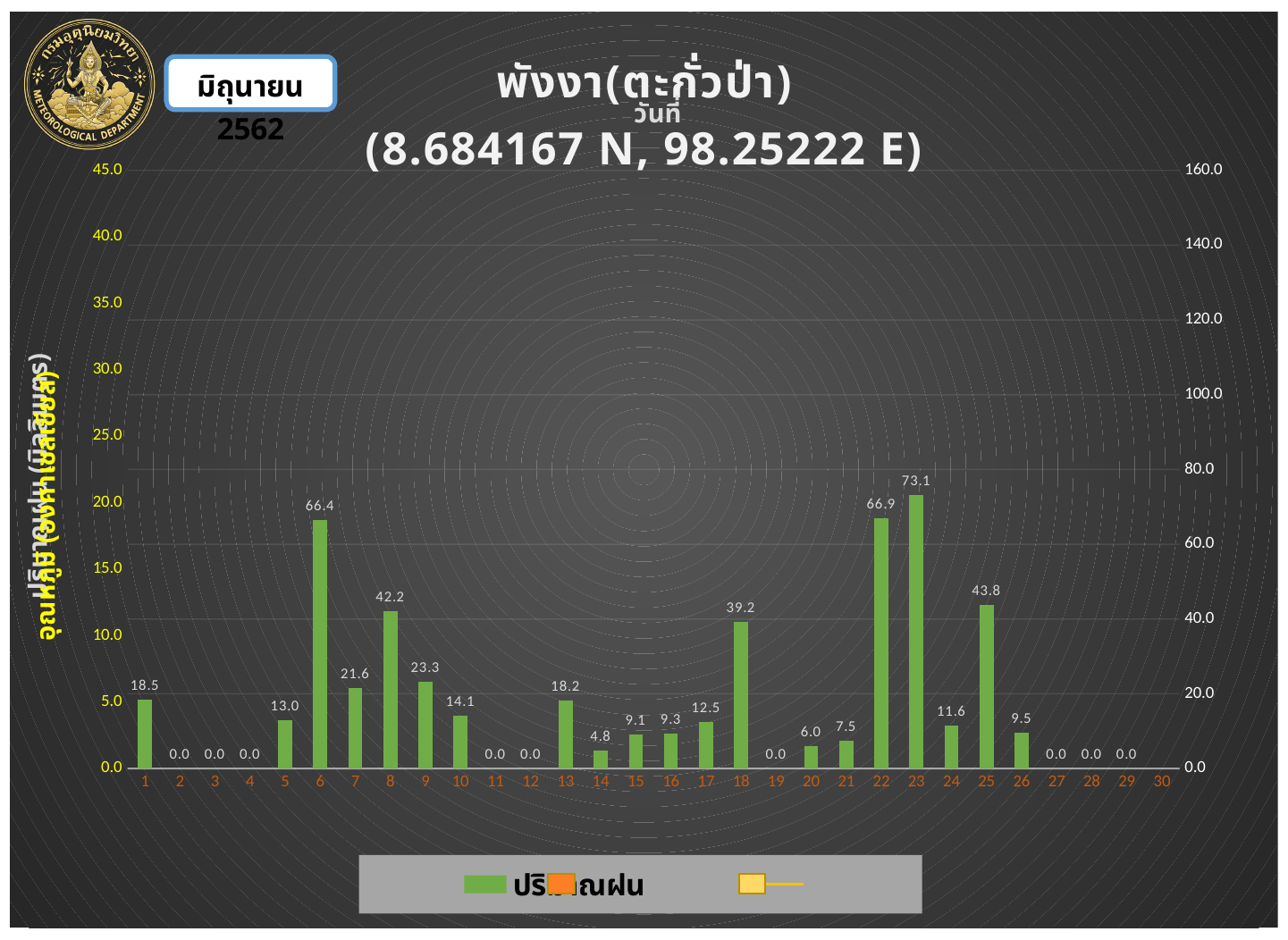
What kind of chart is shown on the slide? bar chart Which is larger, the value for day 8 or the value for day 25? day 25 What is the difference between the values for day 6 and day 8? 24.2 How many days have a value of 0.0 in the chart? 9 What value is labelled on the bar for day 18? 39.2 What is the value shown for day 25? 43.8 What is the value of the bar for day 6? 66.4 Which day has the highest bar in the chart? 23 How many days are shown on the x axis of the chart? 30 What is the difference between the values for day 23 and day 22? 6.2 What is the rainfall value shown for day 23? 73.1 Which is larger, the value for day 1 or the value for day 13? day 1